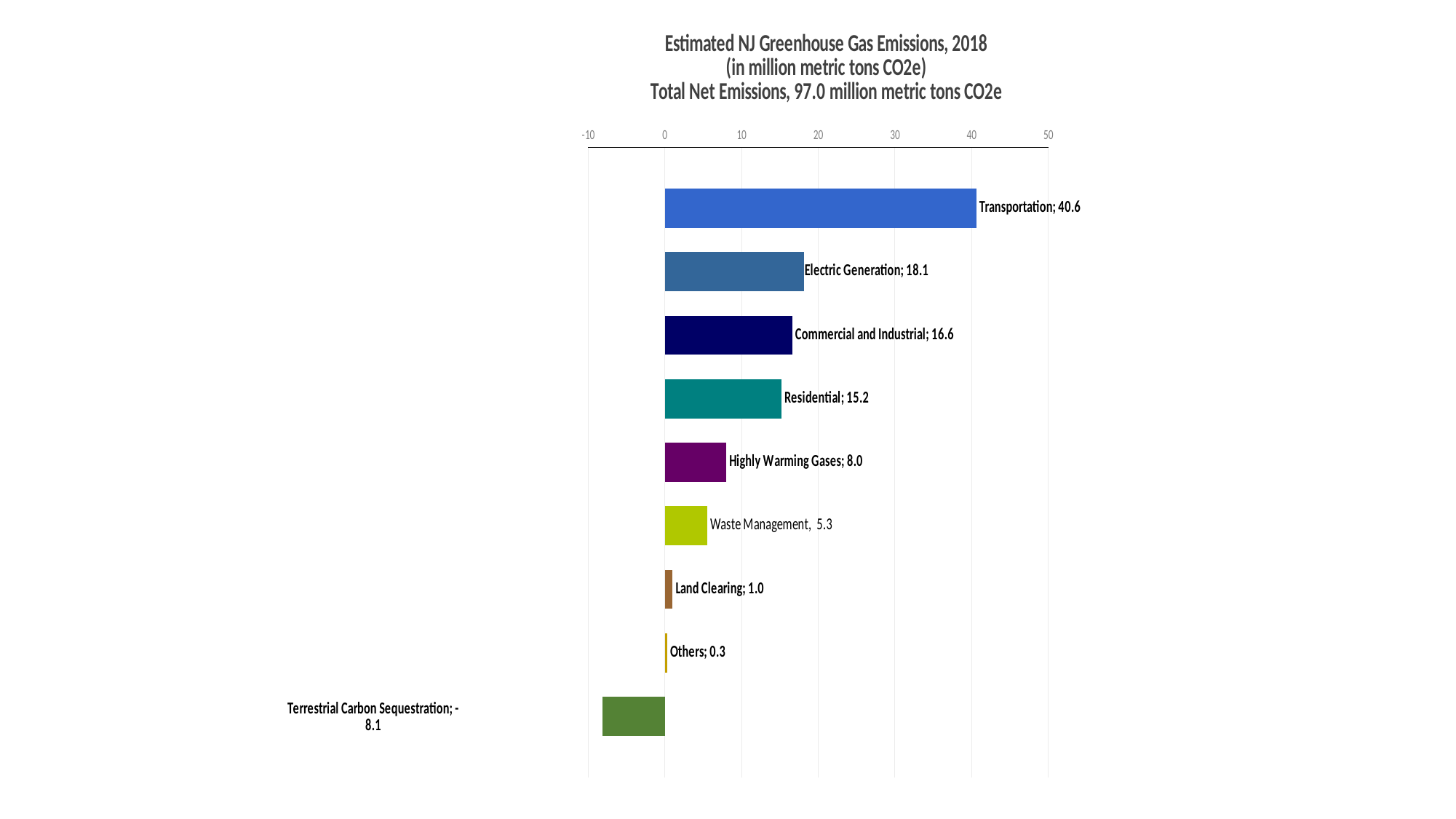
What is the difference between Transportation and Electric Generation? 22.5 What is the value for Waste Management? 5.3 Which is larger, Commercial and Industrial or Residential? Commercial and Industrial What is the value for Electric Generation? 18.1 What kind of chart is this? bar chart Which category has the highest emissions? Transportation Is the value for Highly Warming Gases greater or less than 10? less What total net emissions figure is stated in the chart title? 97.0 million metric tons CO2e How many categories are shown in the chart? 9 What is the value for Transportation? 40.6 Which category has the lowest value? Terrestrial Carbon Sequestration What is the value for Terrestrial Carbon Sequestration? -8.1